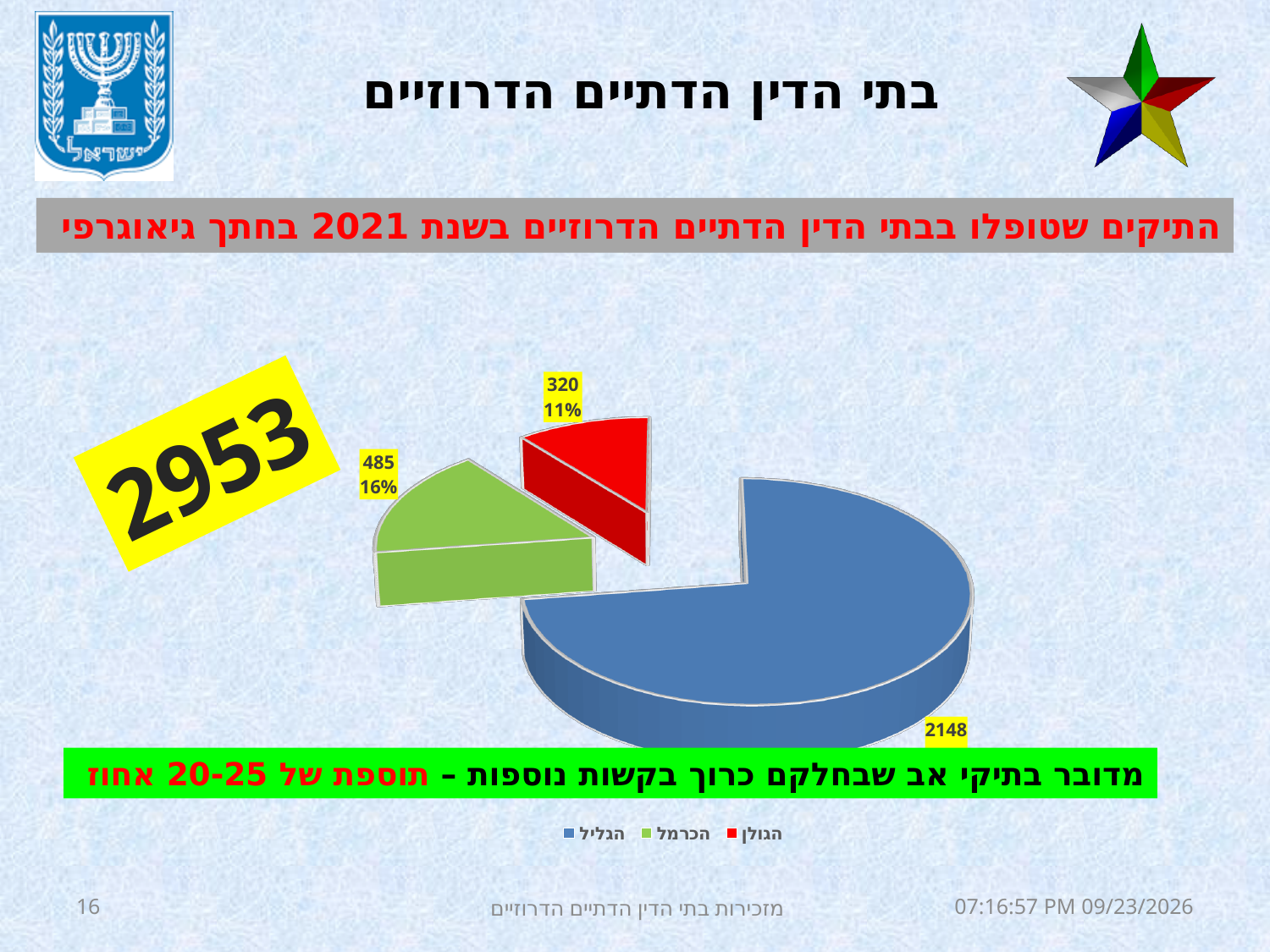
Which category has the largest slice in the pie chart? הגליל Which colour represents הגליל in the pie chart? blue What share of the pie does הכרמל represent? 16% What is the value for הגליל in the pie chart? 2148 How many slices does the pie chart have? 3 What is the difference between the values for הכרמל and הגולן? 165 What is the value for הכרמל in the pie chart? 485 Which category has the smallest slice in the pie chart? הגולן What share of the pie does הגולן represent? 11% What is the value for הגולן in the pie chart? 320 How many entries does the legend of the pie chart list? 3 What type of chart is shown on the slide? pie chart